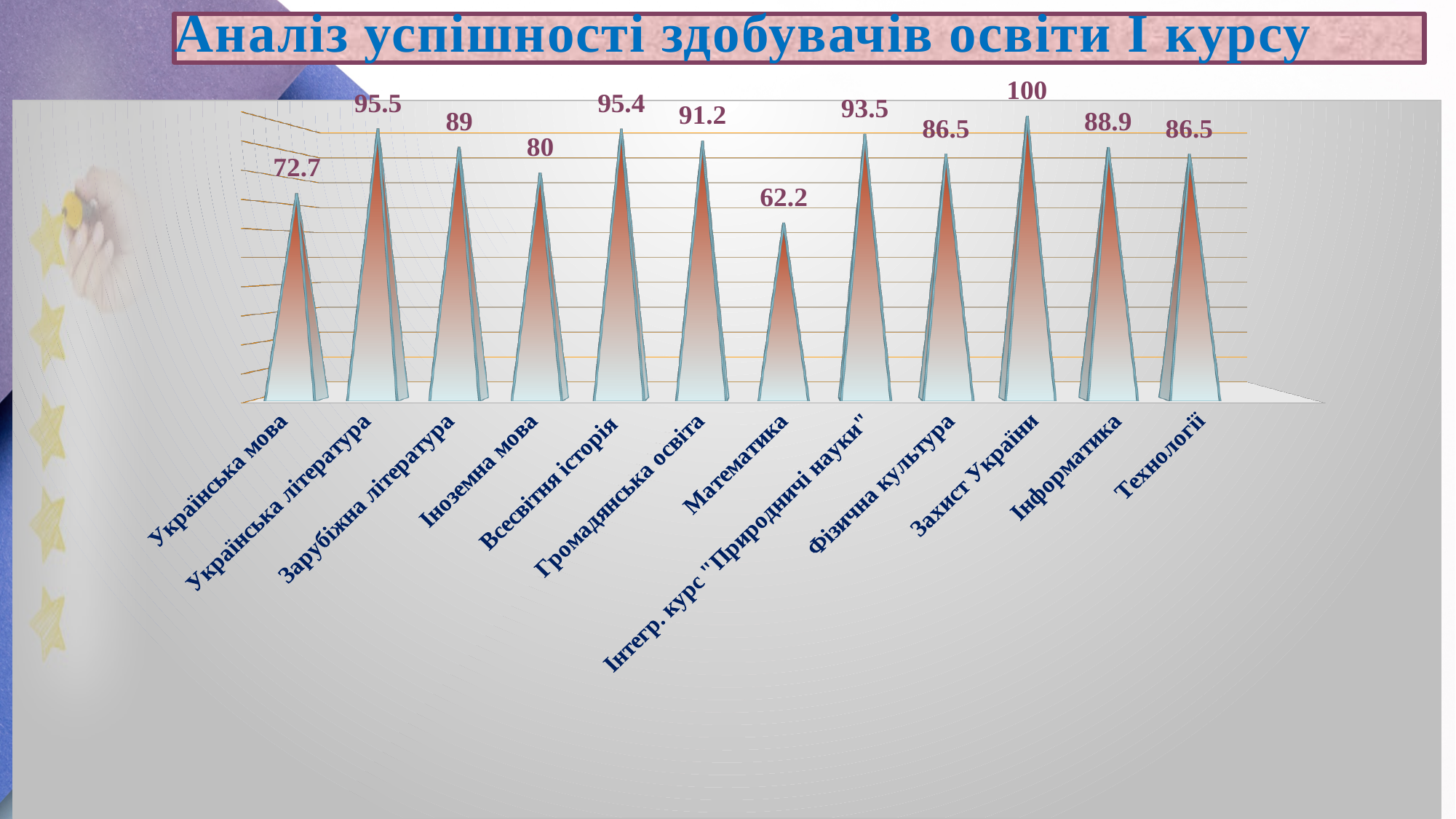
How many subjects are shown on the chart? 12 What is the title of the slide? Аналіз успішності здобувачів освіти І курсу Which subject has the highest value? Захист України What value is shown for Інформатика? 88.9 What is the difference between the values for Зарубіжна література and Іноземна мова? 9 What value is shown for Українська мова? 72.7 What value is shown for Громадянська освіта? 91.2 Which subject has the lowest value? Математика What value is shown for Математика? 62.2 What kind of chart is shown on the slide? bar chart Which is larger, the value for Іноземна мова or the value for Фізична культура? Фізична культура What is the difference between the values for Захист України and Математика? 37.8